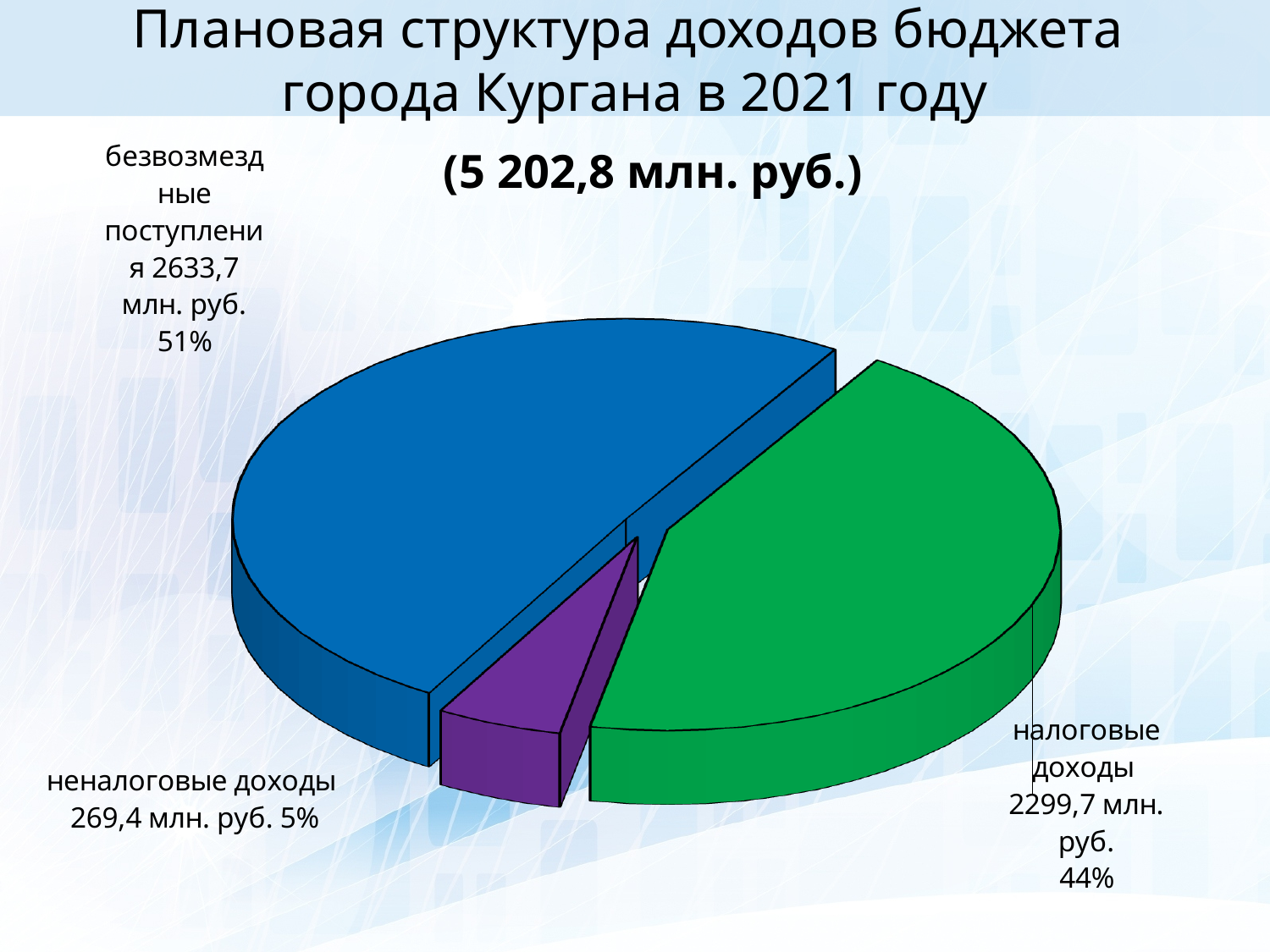
What is the value for неналоговые доходы? 269,4 млн. руб. What is the value for налоговые доходы? 2299,7 млн. руб. What share of the pie do неналоговые доходы make up? 5% Which is larger, безвозмездные поступления or налоговые доходы? безвозмездные поступления Which category has the smallest slice? неналоговые доходы What share of the pie do безвозмездные поступления make up? 51% What kind of chart is shown on the slide? pie chart What share of the pie do налоговые доходы make up? 44% What total amount is shown in the chart title? 5 202,8 млн. руб. What is the value for безвозмездные поступления? 2633,7 млн. руб. How many slices does the pie chart have? 3 Which category has the largest slice? безвозмездные поступления